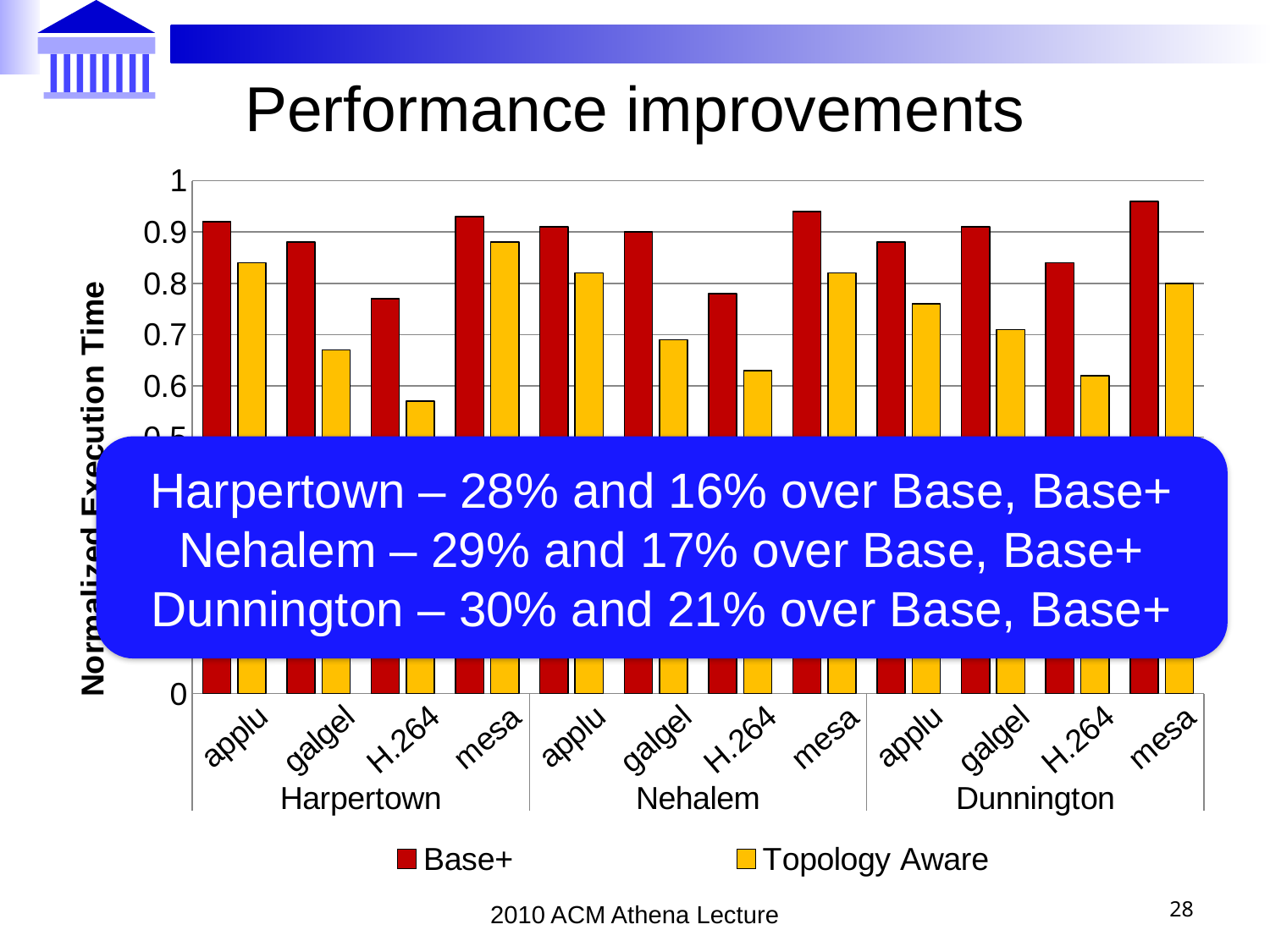
How many benchmarks are plotted within the Nehalem group? 4 Which benchmark and platform has the lowest Topology Aware bar? H.264 on Harpertown For galgel on Harpertown, which is larger: the Base+ value or the Topology Aware value? Base+ Is the Topology Aware value for H.264 on Harpertown greater or less than 0.6? less Is the Base+ value for mesa on Dunnington greater or less than 0.9? greater Is the Base+ value for H.264 on Harpertown greater or less than 0.8? less How many series does the legend list? 2 What kind of chart is shown on the slide? bar chart What is the title of the y axis? Normalized Execution Time How many platform groups are shown along the x axis? 3